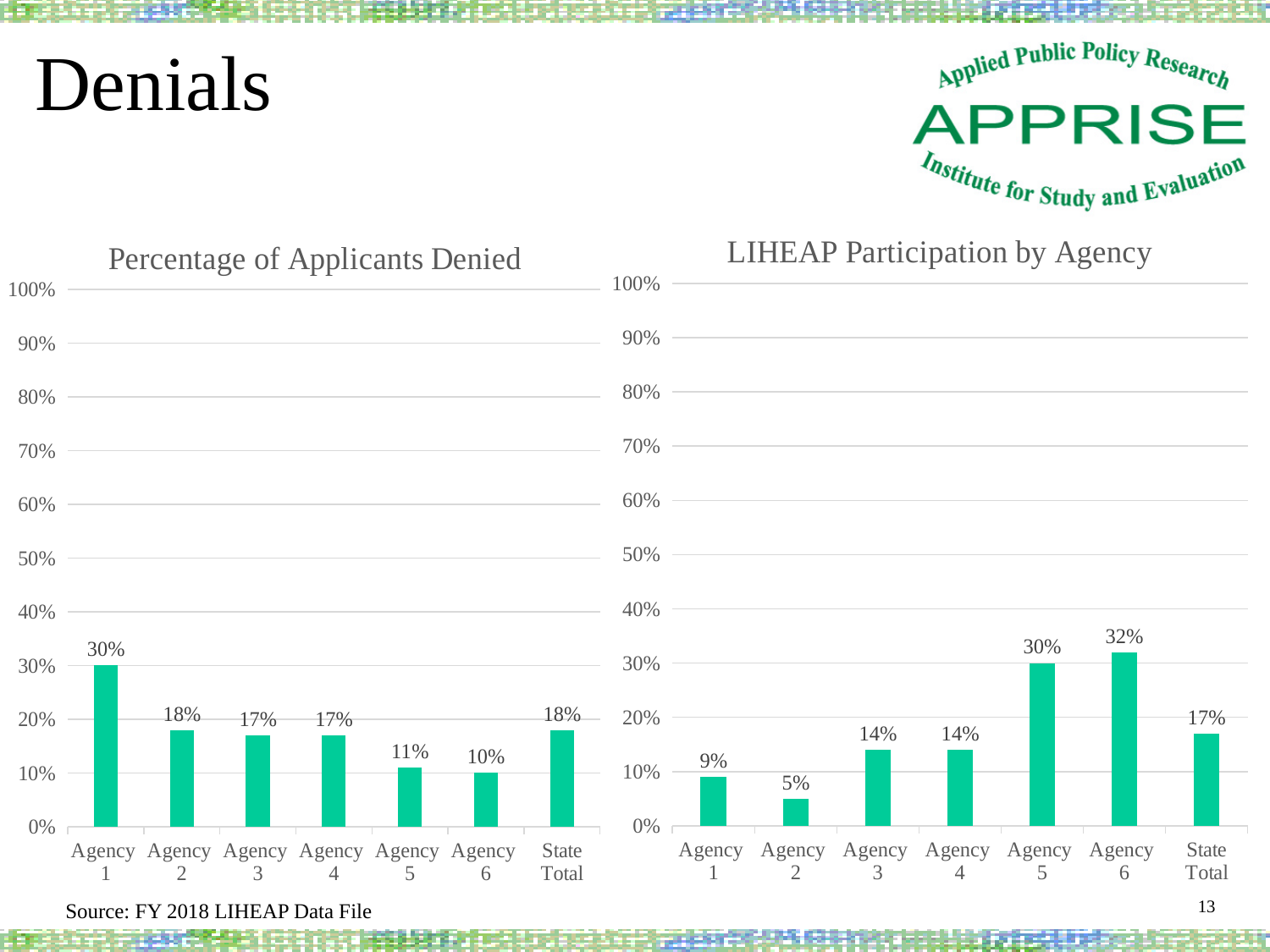
In the 'LIHEAP Participation by Agency' chart, which is larger, Agency 1 or Agency 3? Agency 3 In the 'Percentage of Applicants Denied' chart, is the value for Agency 1 greater or less than 20%? greater In the 'Percentage of Applicants Denied' chart, what is the value for State Total? 18% What is the title of the chart on the right side of the slide? LIHEAP Participation by Agency How many categories are shown in the 'LIHEAP Participation by Agency' chart? 7 In the 'LIHEAP Participation by Agency' chart, which category has the highest value? Agency 6 In the 'Percentage of Applicants Denied' chart, what is the difference between Agency 1 and Agency 5? 19% What kind of chart is the 'Percentage of Applicants Denied' chart? Bar chart In the 'Percentage of Applicants Denied' chart, what is the value for Agency 1? 30% In the 'Percentage of Applicants Denied' chart, which category has the lowest value? Agency 6 In the 'LIHEAP Participation by Agency' chart, what is the difference between Agency 6 and State Total? 15% In the 'LIHEAP Participation by Agency' chart, what is the value for Agency 2? 5%